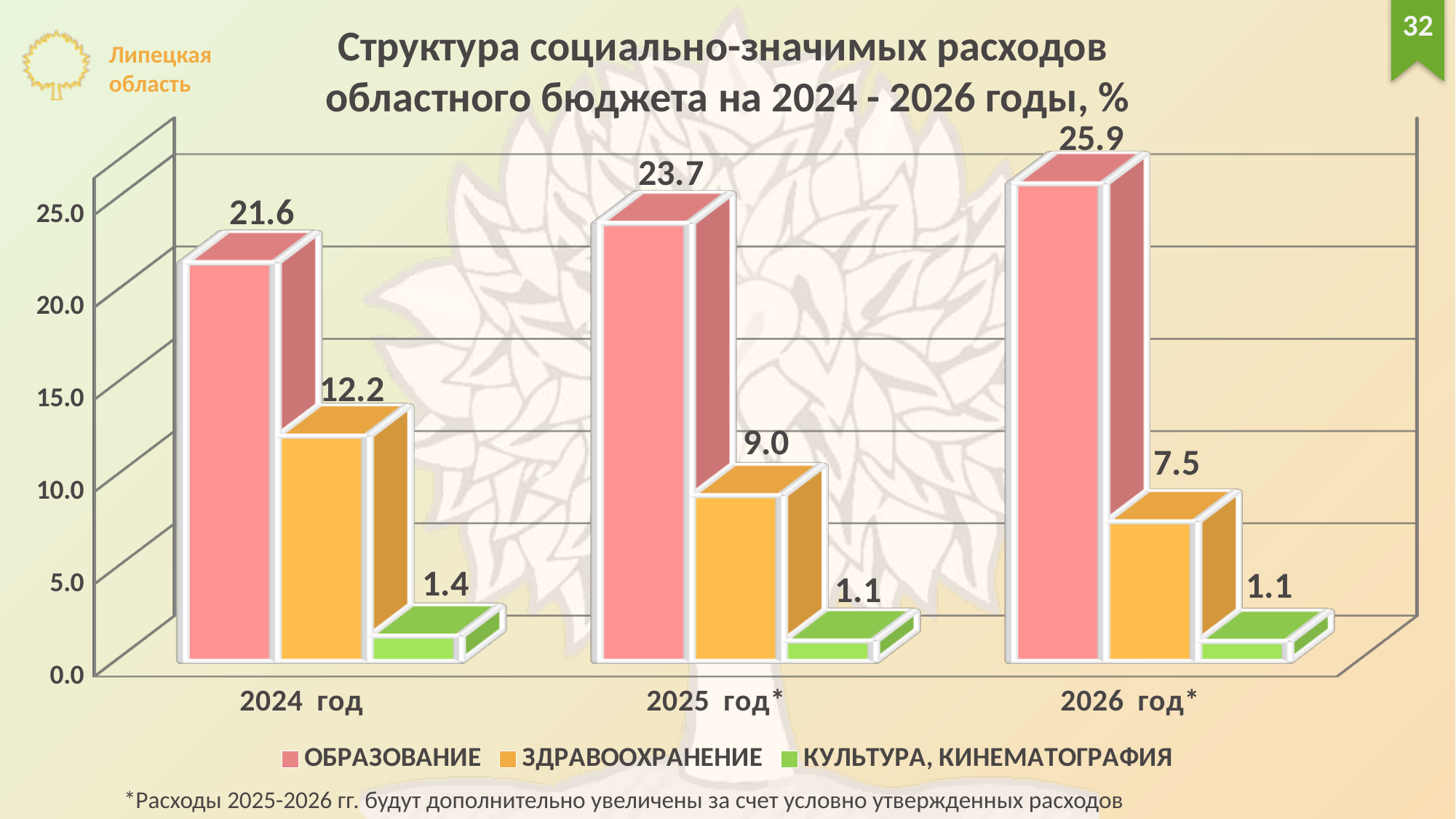
In which year is the value for ЗДРАВООХРАНЕНИЕ lowest? 2026 год* What is the difference between the ОБРАЗОВАНИЕ values for 2026 год* and 2024 год? 4.3 Does the value for ОБРАЗОВАНИЕ rise or fall from 2024 год to 2026 год*? rise What kind of chart is shown on the slide? bar chart Which is larger: ЗДРАВООХРАНЕНИЕ in 2024 год or ЗДРАВООХРАНЕНИЕ in 2025 год*? 2024 год What is the value for КУЛЬТУРА, КИНЕМАТОГРАФИЯ in 2024 год? 1.4 What is the value for ОБРАЗОВАНИЕ in 2024 год? 21.6 Which colour represents КУЛЬТУРА, КИНЕМАТОГРАФИЯ in the legend? green What is the value for ЗДРАВООХРАНЕНИЕ in 2026 год*? 7.5 How many series does the legend list? 3 How many years are shown on the x axis? 3 In which year is the value for ОБРАЗОВАНИЕ highest? 2026 год*